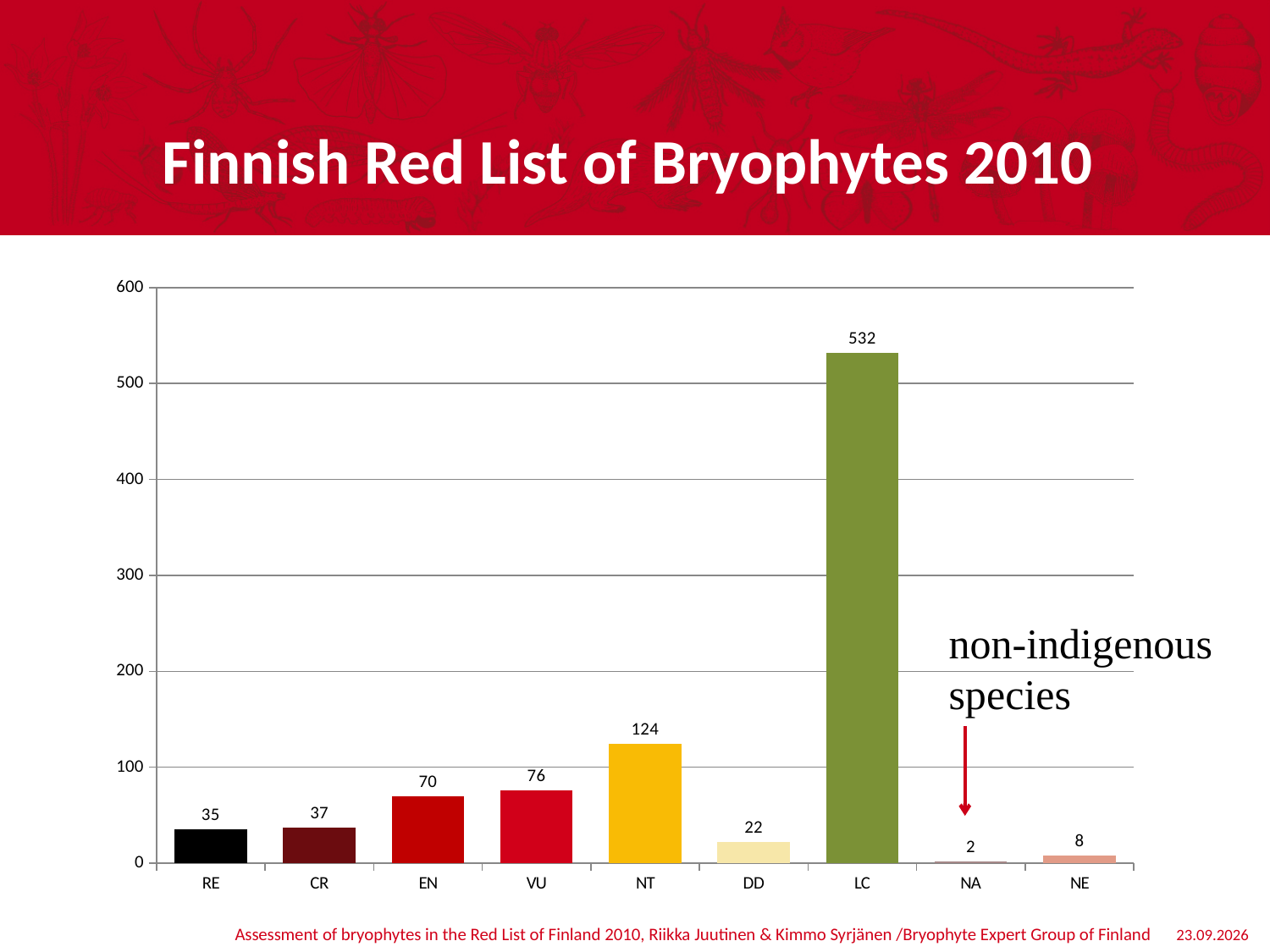
What is the value for LC? 532 What is the value for NT? 124 Which category has the highest value? LC How many categories are shown on the x axis? 9 What is the value for DD? 22 Which is larger, the value for CR or the value for RE? CR Which category has the lowest value? NA What is the difference between the values for VU and EN? 6 What is the title of the slide? Finnish Red List of Bryophytes 2010 Is the value for NT greater or less than 100? greater What is the difference between the values for LC and NT? 408 What kind of chart is shown on the slide? bar chart